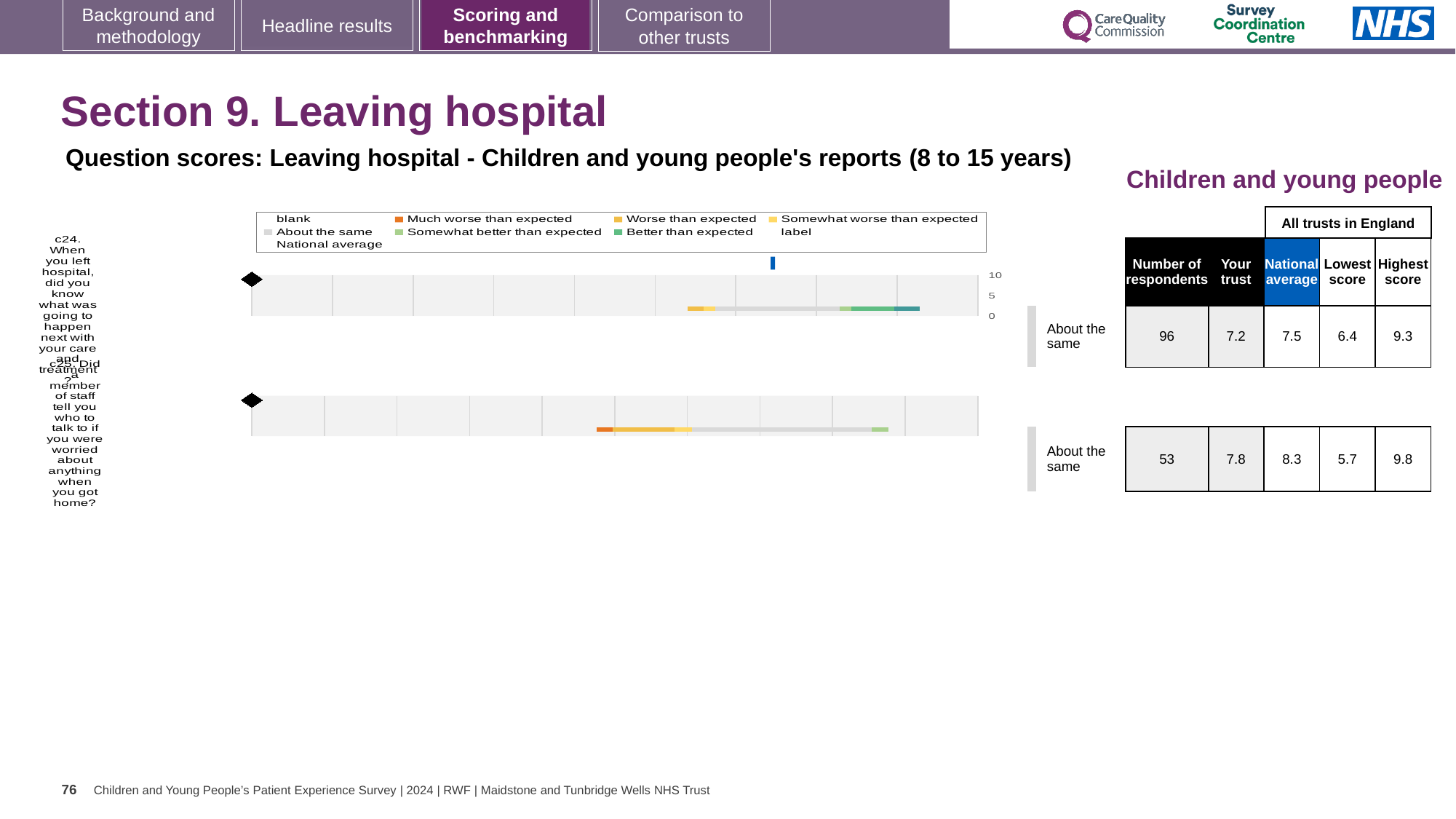
What is the highest score among all trusts in England for question c24? 9.3 What kind of chart is used to show the question scores on this slide? Bar chart What is the lowest score among all trusts in England for question c25? 5.7 What is the national average score for question c25 (Did a member of staff tell you who to talk to if you were worried about anything when you got home?)? 8.3 What is the difference between the national average and the trust's score for question c25? 0.5 How many survey questions are plotted on the slide's charts? 2 Which colour in the legend represents 'Much worse than expected'? Orange Which question had more respondents, c24 or c25? c24 What benchmark category is the trust placed in for question c24? About the same How many respondents answered question c24? 96 Is the trust's score for question c24 higher or lower than the national average? Lower What is the 'Your trust' score for question c24 (When you left hospital, did you know what was going to happen next with your care and treatment?)? 7.2